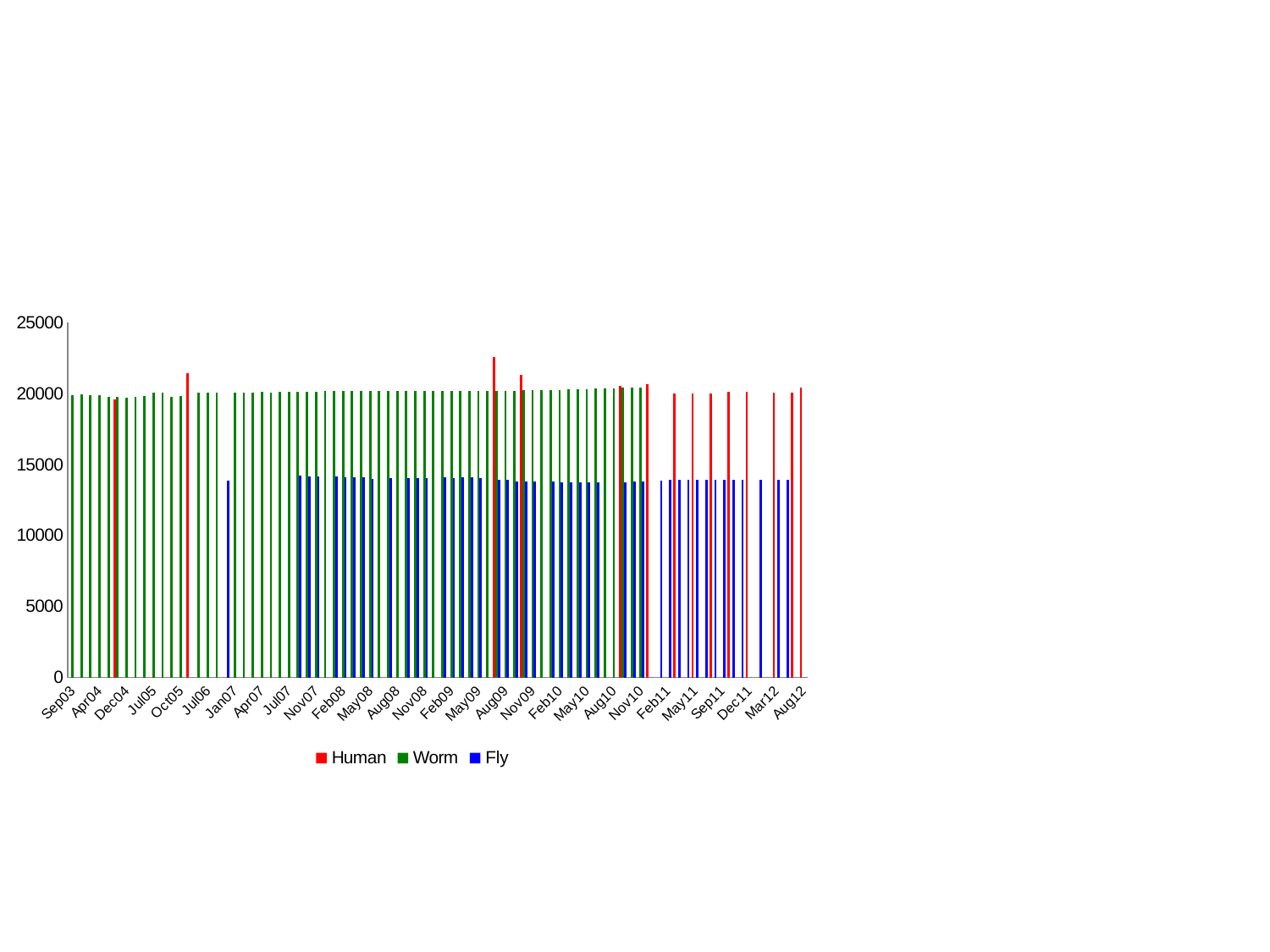
At Nov07, which series has the larger value, Worm or Fly? Worm How many series does the legend list? 3 Is the value for Worm at Jul07 greater or less than 15000? greater Which series has the lowest values on the chart? Fly What kind of chart is shown on the slide? bar chart What colour represents the Fly series? blue Is the value for Fly at Feb08 greater or less than 15000? less What are the series names listed in the legend? Human, Worm, Fly Which series reaches the highest value anywhere on the chart? Human